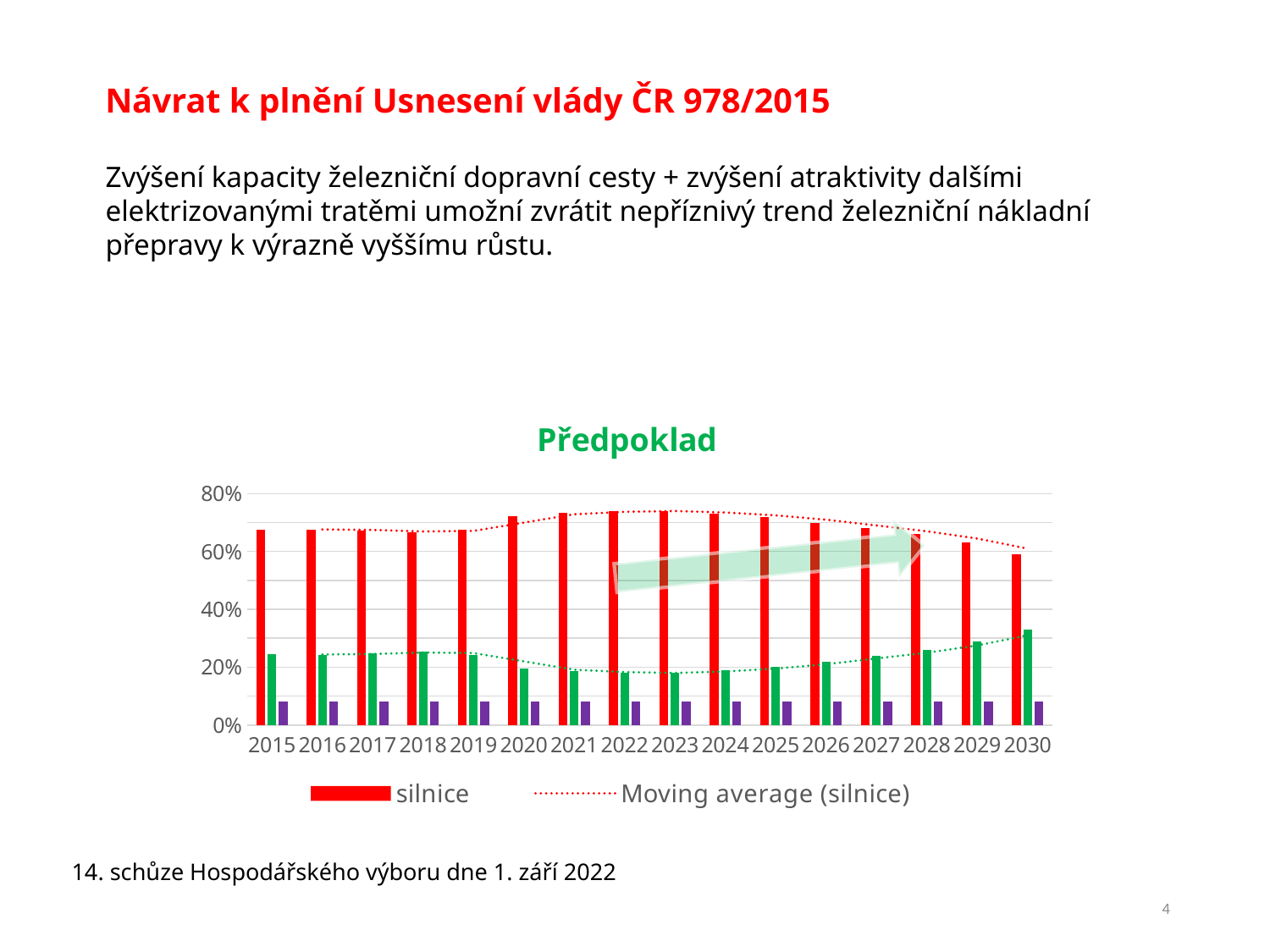
What kind of chart is shown under the title "Předpoklad"? bar chart What is the title of the chart on the slide? Předpoklad Is the "silnice" value for 2030 greater or less than 80%? less How many entries does the legend of the "Předpoklad" chart list? 2 How many years are shown on the x axis of the "Předpoklad" chart? 16 Is the "silnice" value for 2015 greater or less than 60%? greater Do the "silnice" values rise or fall from 2023 to 2030? fall Is the "silnice" value for 2023 greater or less than 80%? less Which year has the lowest "silnice" value? 2030 What colour are the "silnice" bars in the chart? red Which is larger, the "silnice" value for 2015 or for 2030? 2015